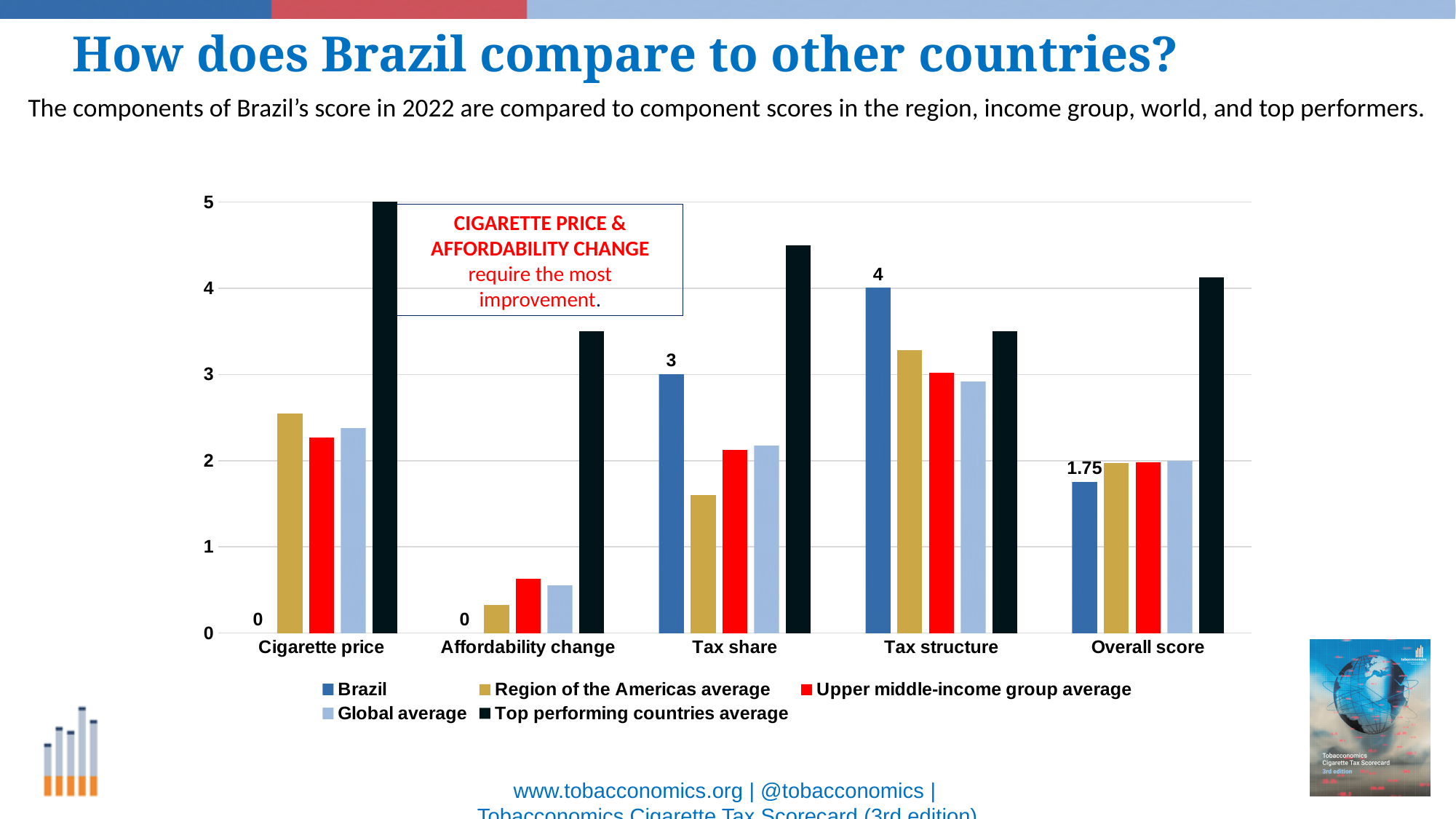
What is the difference between Brazil's Tax structure value and its Tax share value? 1 What is Brazil's value for Tax structure? 4 What is Brazil's value for Cigarette price? 0 How many categories are shown on the x axis? 5 Is the Top performing countries average for Affordability change greater or less than 3? greater What is Brazil's Overall score? 1.75 What is Brazil's value for Tax share? 3 How many series does the legend list? 5 In which category does Brazil have its highest value? Tax structure Is the Global average for Affordability change greater or less than 1? less Which series has the highest value in the Tax share category? Top performing countries average Which is larger for Brazil: Tax share or Overall score? Tax share